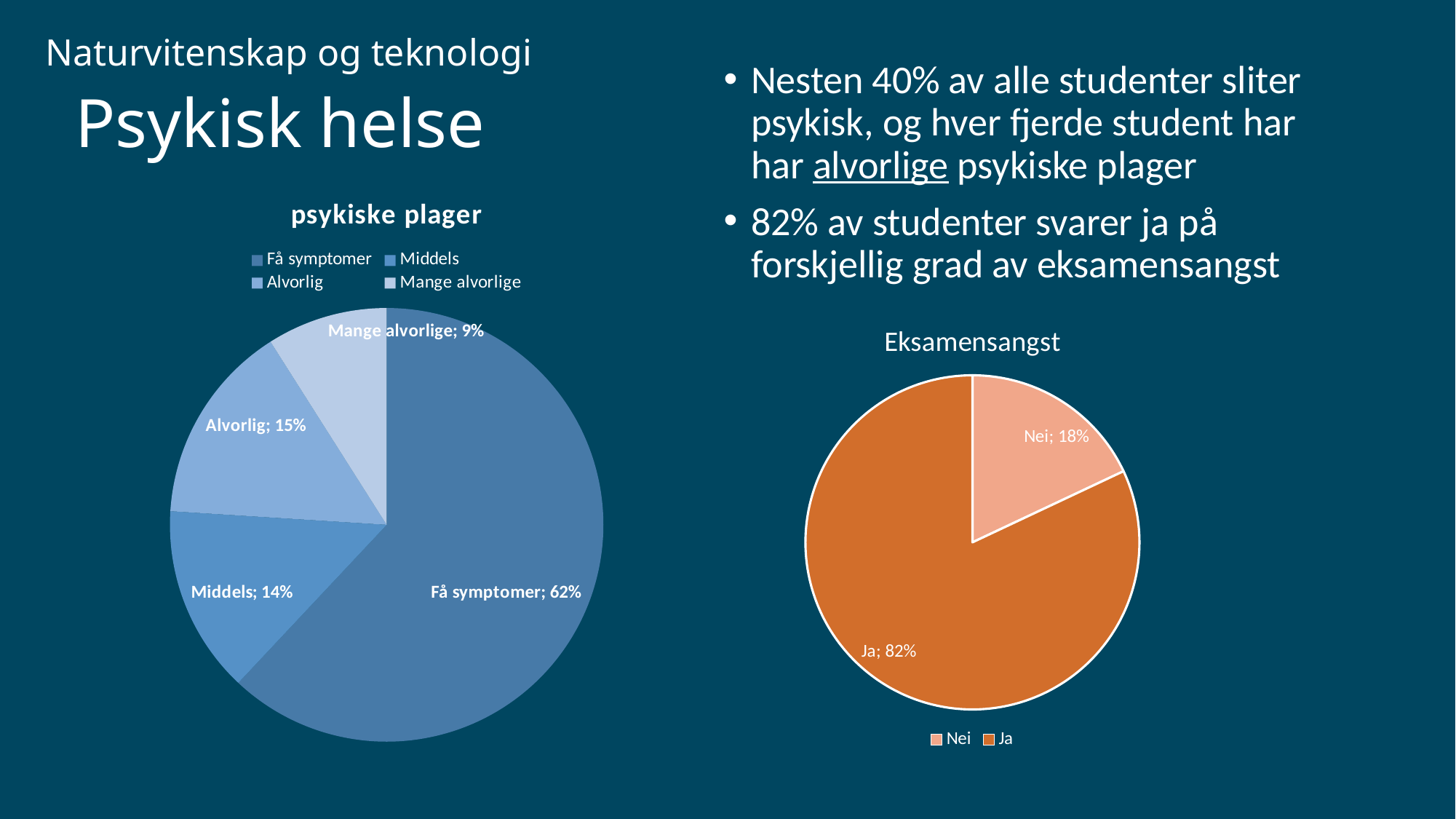
In the 'psykiske plager' chart, what is the value for 'Alvorlig'? 15% In the 'Eksamensangst' chart, what share of the pie is 'Ja'? 82% In the 'psykiske plager' chart, which category has the largest slice? Få symptomer In the 'Eksamensangst' chart, how many entries does the legend list? 2 In the 'psykiske plager' chart, what share of the pie is 'Få symptomer'? 62% In the 'Eksamensangst' chart, what is the difference between 'Ja' and 'Nei'? 64% In the 'psykiske plager' chart, what is the difference between 'Få symptomer' and 'Middels'? 48% In the 'Eksamensangst' chart, what is the value for 'Nei'? 18% In the 'psykiske plager' chart, how many categories are shown? 4 In the 'psykiske plager' chart, which category has the smallest slice? Mange alvorlige What kind of chart is the 'Eksamensangst' chart? Pie chart In the 'psykiske plager' chart, what is the value for 'Mange alvorlige'? 9%